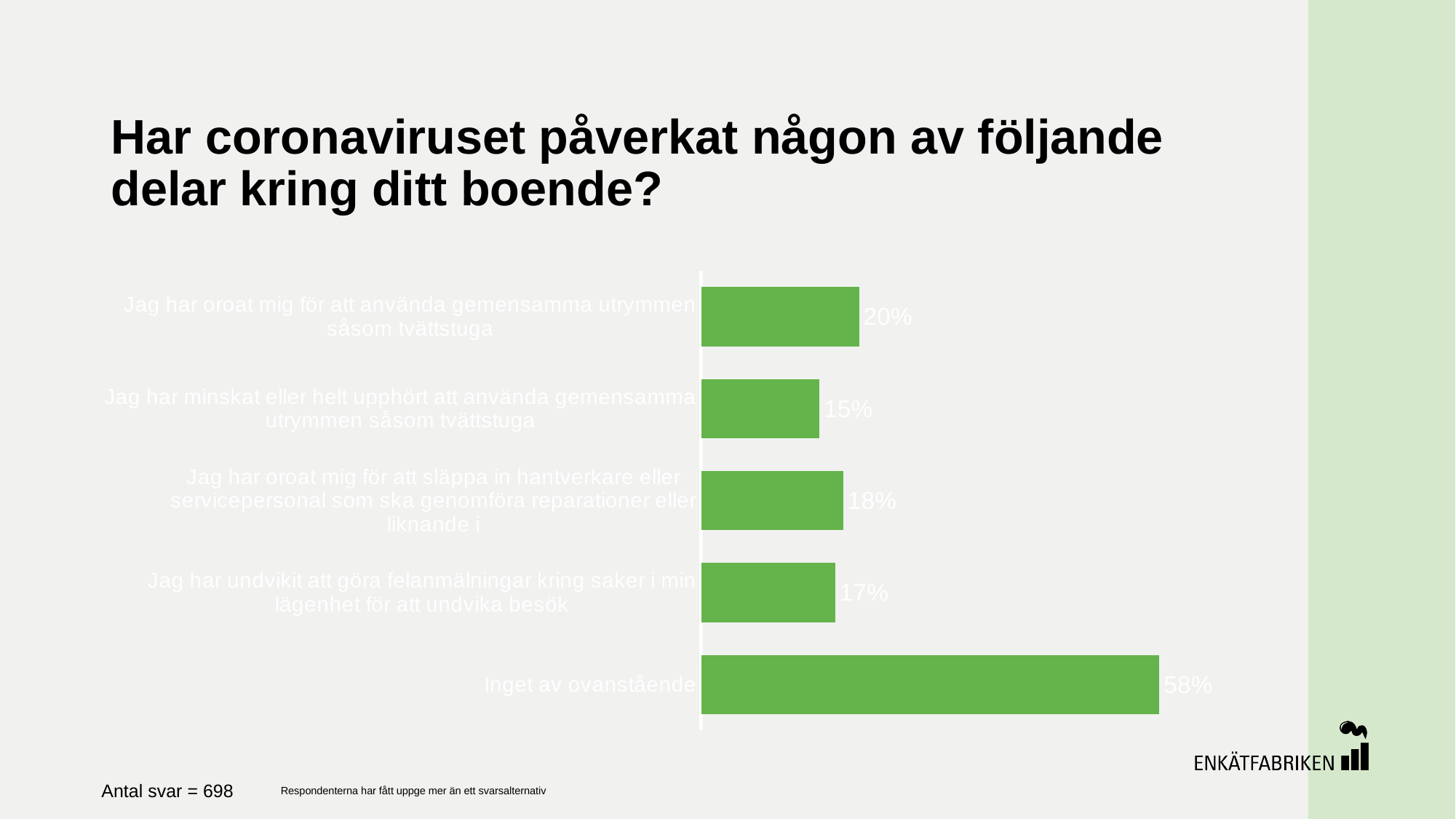
What is the value for "Inget av ovanstående"? 58% What is the value for "Jag har undvikit att göra felanmälningar kring saker i min lägenhet för att undvika besök"? 17% What kind of chart is shown on the slide? bar chart How many categories does the chart show? 5 What is the difference between the value for "Inget av ovanstående" and the value for "Jag har oroat mig för att använda gemensamma utrymmen såsom tvättstuga"? 38% What colour are the bars in the chart? green What is the value for "Jag har minskat eller helt upphört att använda gemensamma utrymmen såsom tvättstuga"? 15% What is the number of respondents (Antal svar) stated on the slide? 698 Which category has the highest value? Inget av ovanstående Which is larger: the value for "Jag har oroat mig för att släppa in hantverkare eller servicepersonal som ska genomföra reparationer eller liknande i" or the value for "Jag har undvikit att göra felanmälningar kring saker i min lägenhet för att undvika besök"? Jag har oroat mig för att släppa in hantverkare eller servicepersonal som ska genomföra reparationer eller liknande i What is the value for "Jag har oroat mig för att använda gemensamma utrymmen såsom tvättstuga"? 20% Which category has the lowest value? Jag har minskat eller helt upphört att använda gemensamma utrymmen såsom tvättstuga